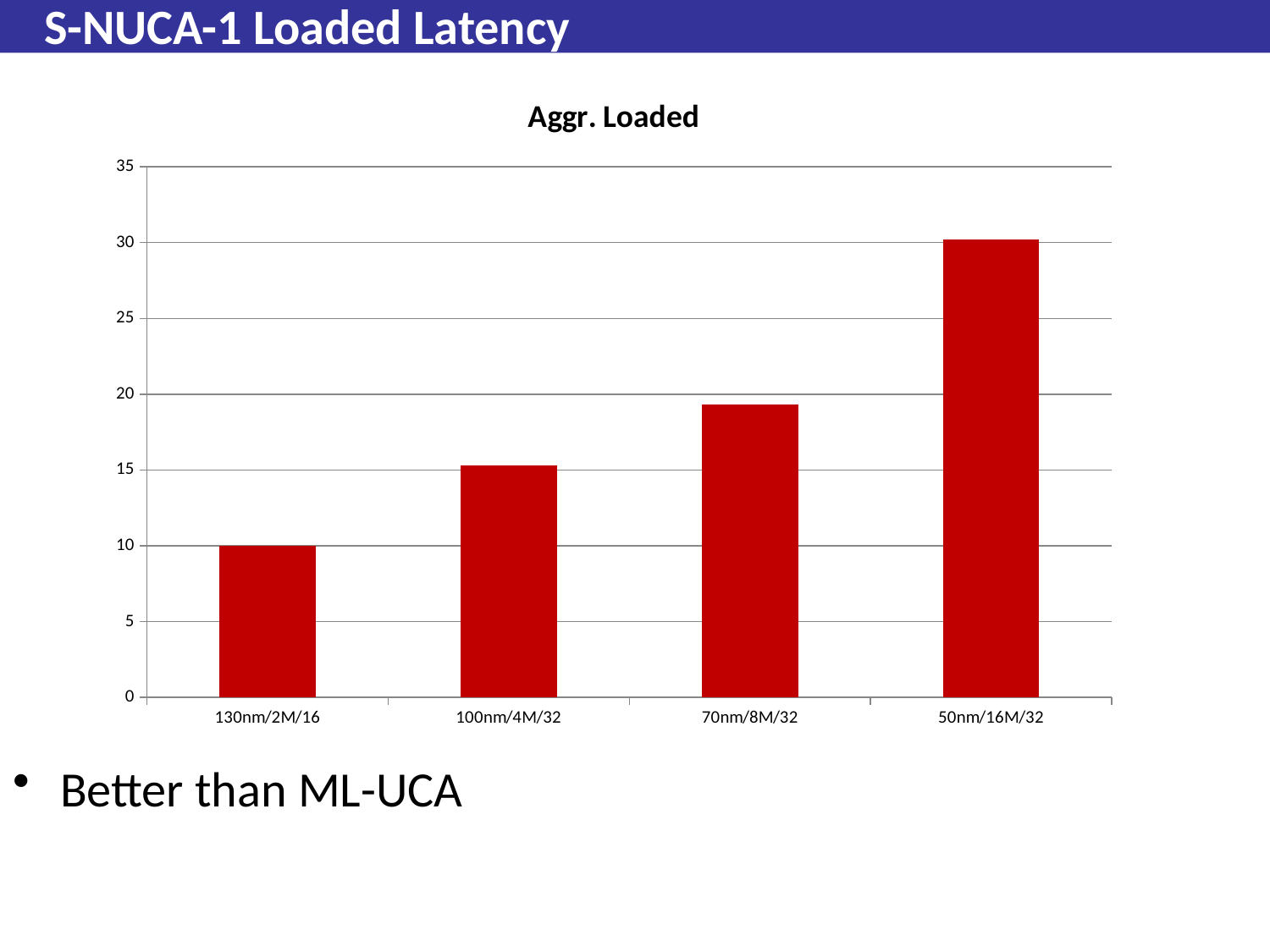
Is the value for 100nm/4M/32 greater or less than 20? less Do the values rise or fall moving left to right along the x axis? rise What colour are the bars in the chart? red Which category has the highest value in the chart? 50nm/16M/32 Which is larger, the value for 70nm/8M/32 or the value for 100nm/4M/32? 70nm/8M/32 How many categories are shown on the x axis of the chart? 4 Which category has the lowest value in the chart? 130nm/2M/16 Is the value for 50nm/16M/32 greater or less than 25? greater What is the value for 130nm/2M/16? 10 Is the value for 70nm/8M/32 greater or less than 15? greater What type of chart is shown on the slide? bar chart What is the title of the chart? Aggr. Loaded